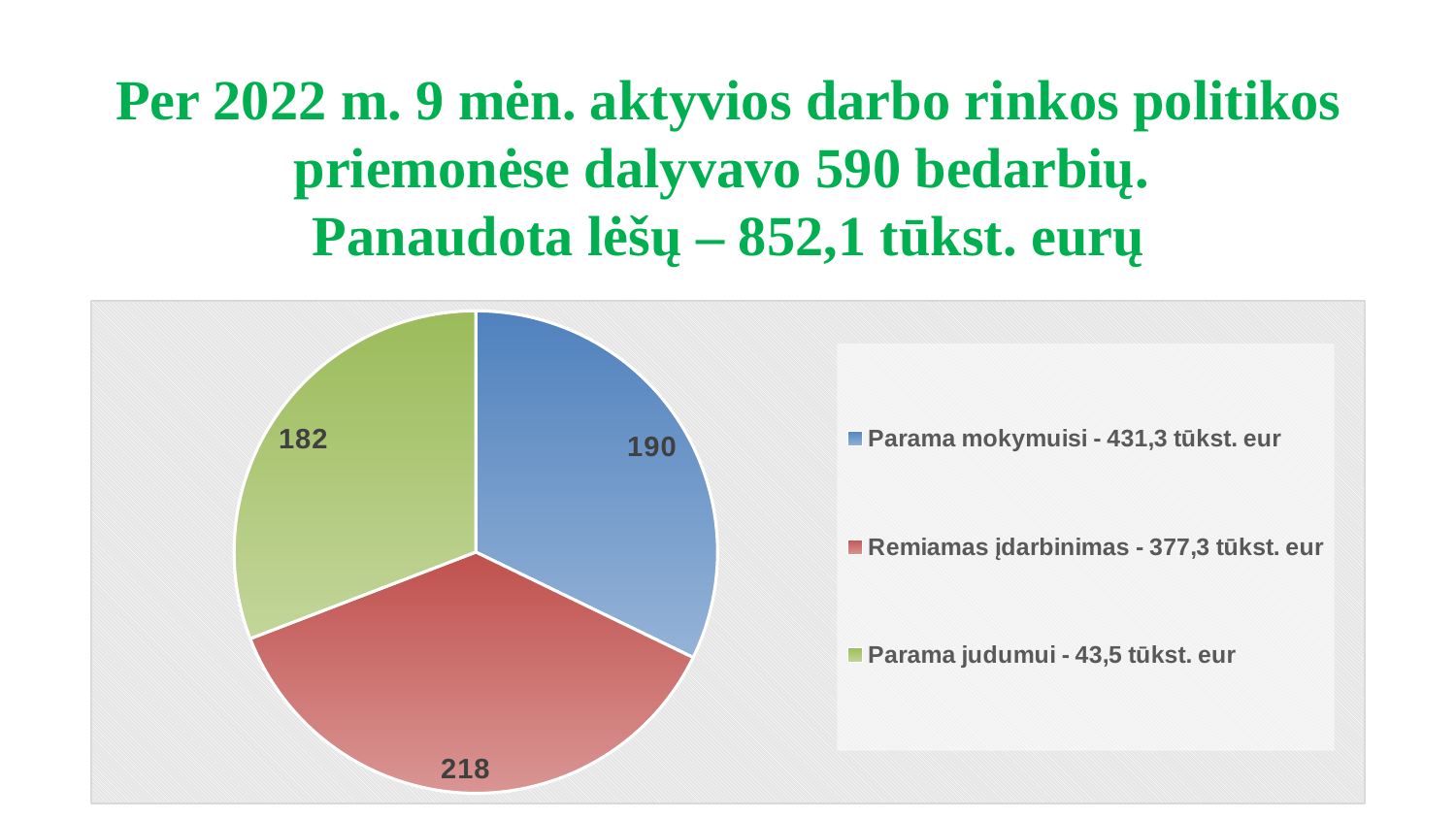
What type of chart is shown on the slide? pie chart Which is larger, the value for Parama mokymuisi or the value for Parama judumui? Parama mokymuisi What is the difference between the values for Remiamas įdarbinimas and Parama judumui? 36 What is the value of the slice for Remiamas įdarbinimas? 218 What is the value of the slice for Parama judumui? 182 How many slices does the pie chart have? 3 According to the legend, what amount in tūkst. eur is associated with Parama judumui? 43,5 tūkst. eur Which category has the smallest slice in the pie chart? Parama judumui What is the total of all three slices in the pie chart? 590 What is the value of the slice for Parama mokymuisi? 190 Which category has the largest slice in the pie chart? Remiamas įdarbinimas How many entries does the legend list? 3